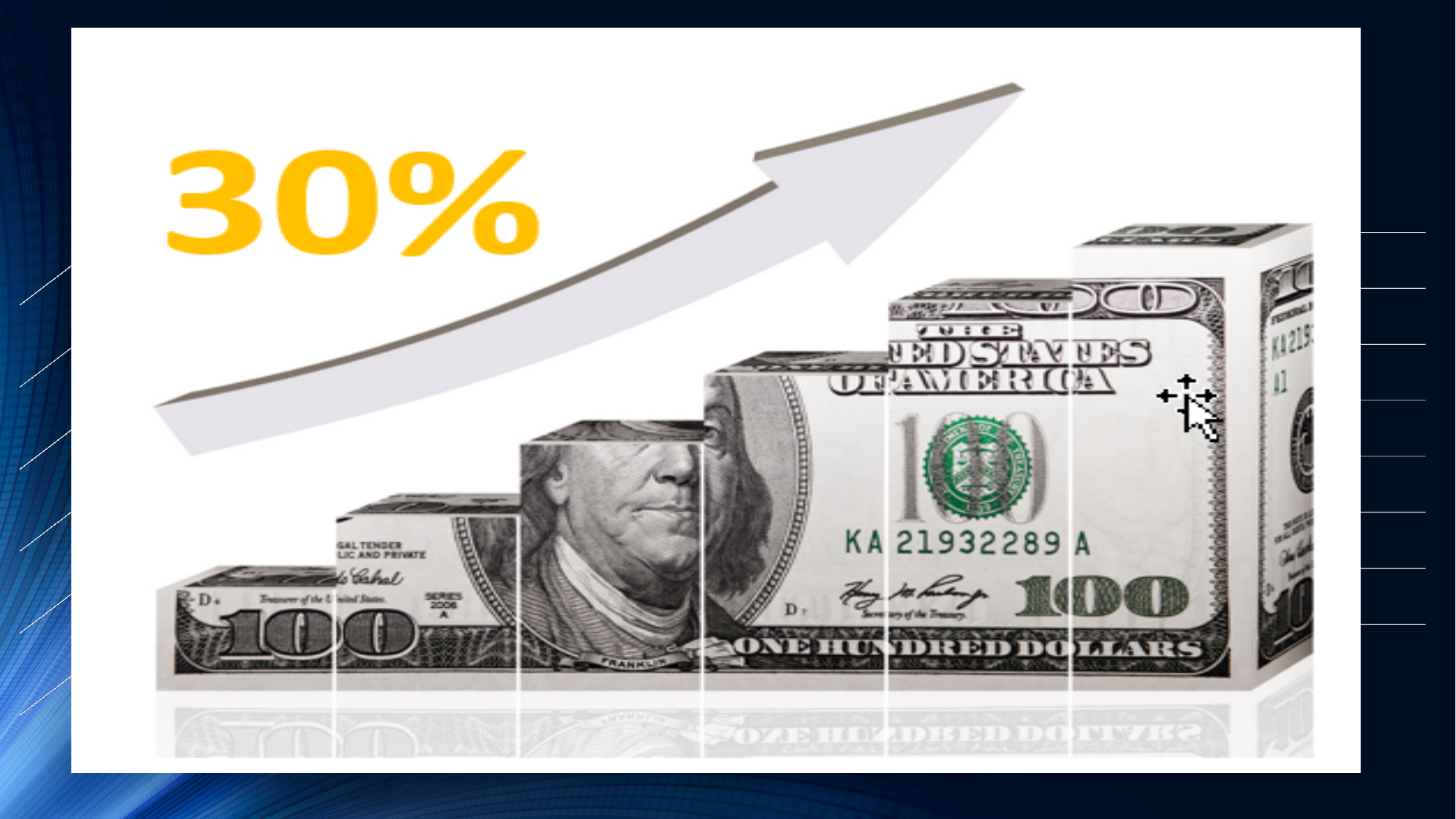
In which direction does the arrow above the bars point? upward to the right Which bar is the tallest, the leftmost or the rightmost? rightmost What percentage figure is printed above the chart? 30% How many bars are shown in the chart? 6 Which bar is the shortest, the leftmost or the rightmost? leftmost What kind of chart is depicted on the slide? bar chart Do the bars rise or fall from left to right? rise